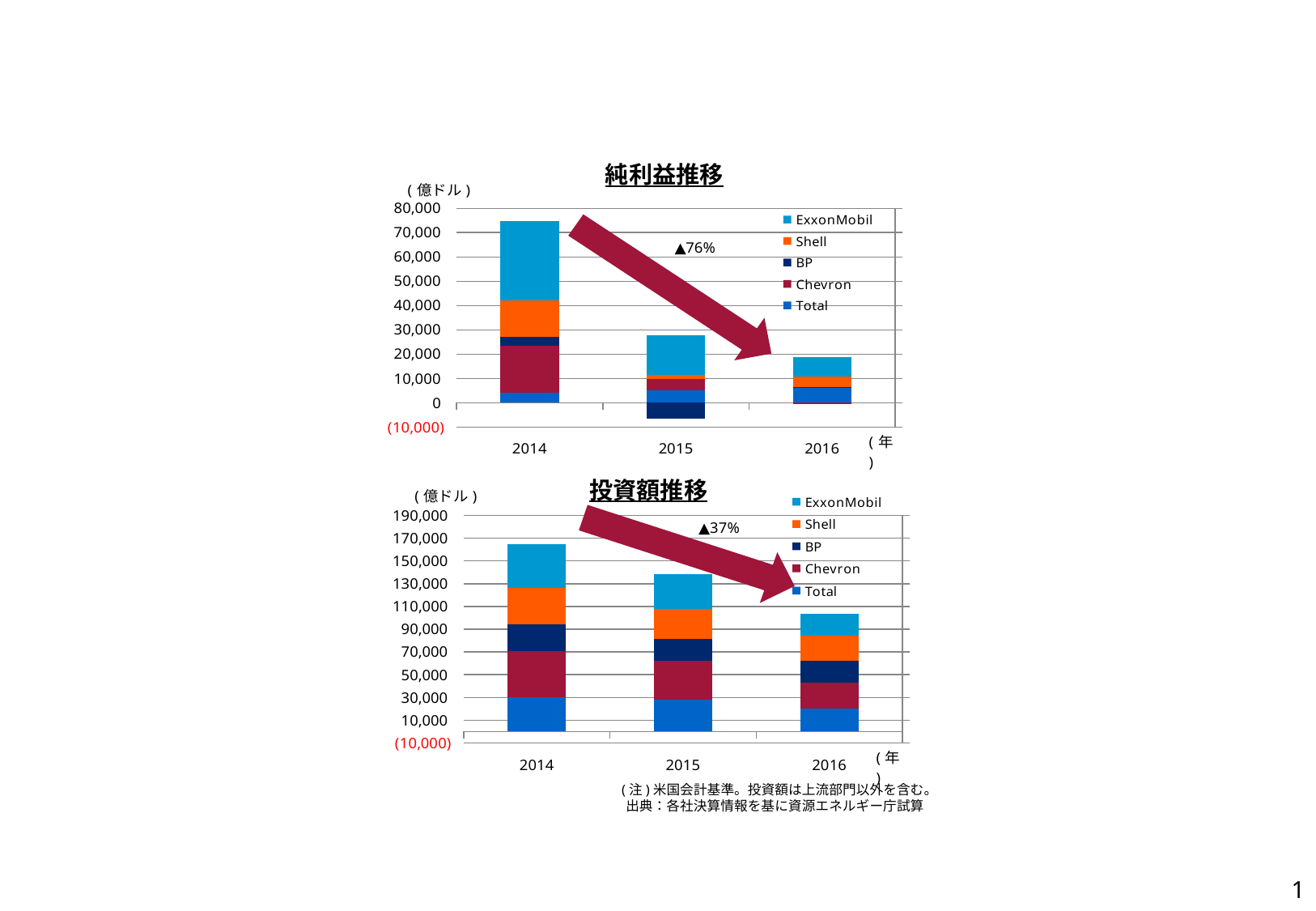
In the bottom chart (投資額推移), which year has the highest stacked total? 2014 In the bottom chart (投資額推移), do the stacked totals rise or fall from 2014 to 2016? fall What percentage decline is annotated on the bottom chart (投資額推移)? ▲37% In the top chart (純利益推移), is the stacked total for 2014 greater or less than 70,000? greater How many series does the legend of the top chart (純利益推移) list? 5 In the top chart (純利益推移), which year has the lowest stacked total? 2016 In the bottom chart (投資額推移), is the stacked total for 2014 greater or less than 150,000? greater In the top chart (純利益推移), is the stacked total for 2016 greater or less than 30,000? less In the top chart (純利益推移), do the stacked totals rise or fall from 2014 to 2016? fall How many years are shown on the x axis of the bottom chart (投資額推移)? 3 What kind of chart is the top chart titled 純利益推移? stacked bar chart